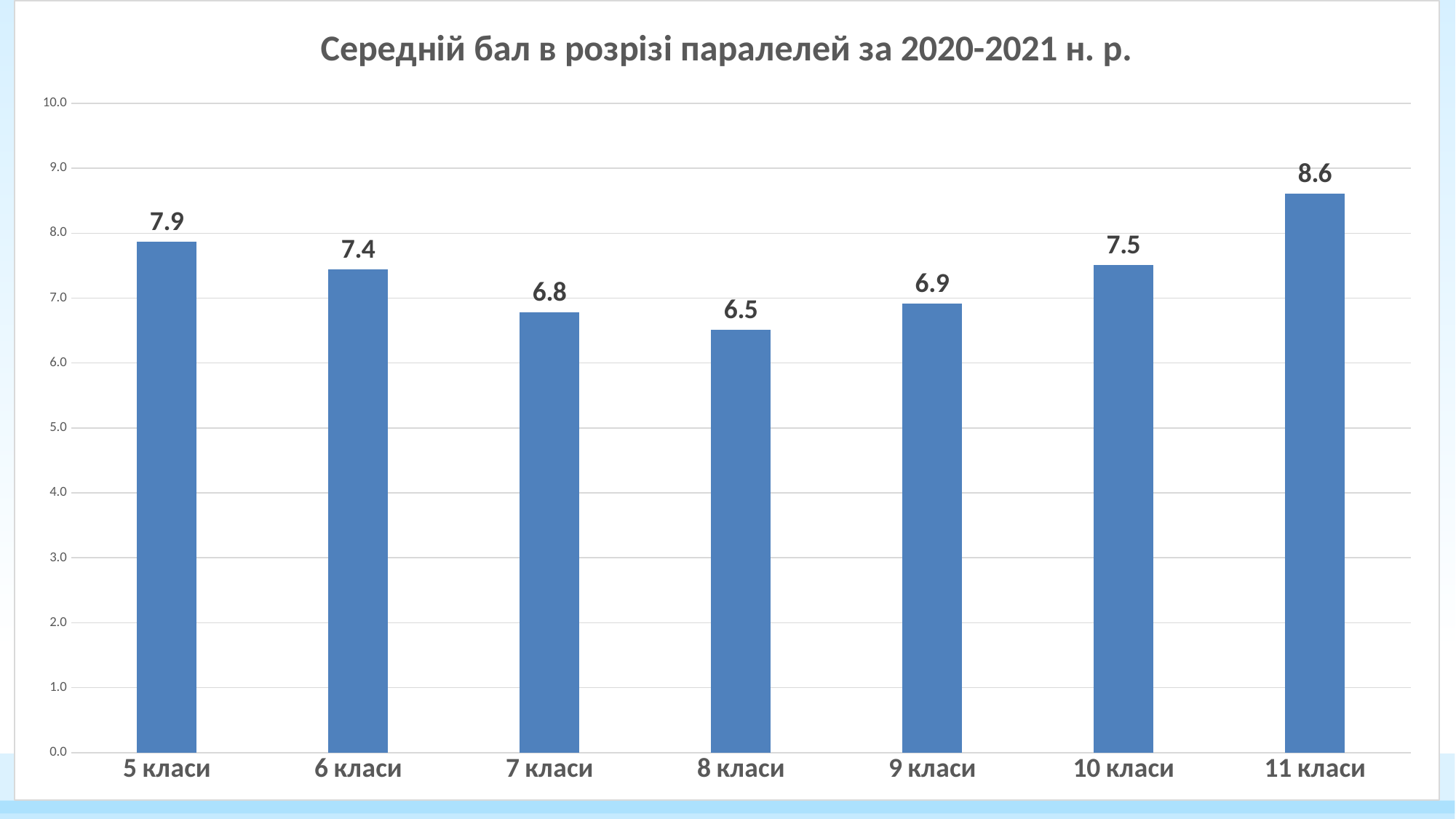
What is the average score for 5 класи? 7.9 What is the difference between the average scores of 11 класи and 8 класи? 2.1 What is the title of the chart? Середній бал в розрізі паралелей за 2020-2021 н. р. What is the difference between the average scores of 5 класи and 6 класи? 0.5 What is the average score for 8 класи? 6.5 Is the value for 11 класи greater or less than 8.0? greater Which has a higher average score, 7 класи or 9 класи? 9 класи What type of chart is shown on the slide? Bar chart What is the average score for 10 класи? 7.5 How many parallels (categories) are shown on the chart? 7 Which parallel has the highest average score? 11 класи Which parallel has the lowest average score? 8 класи